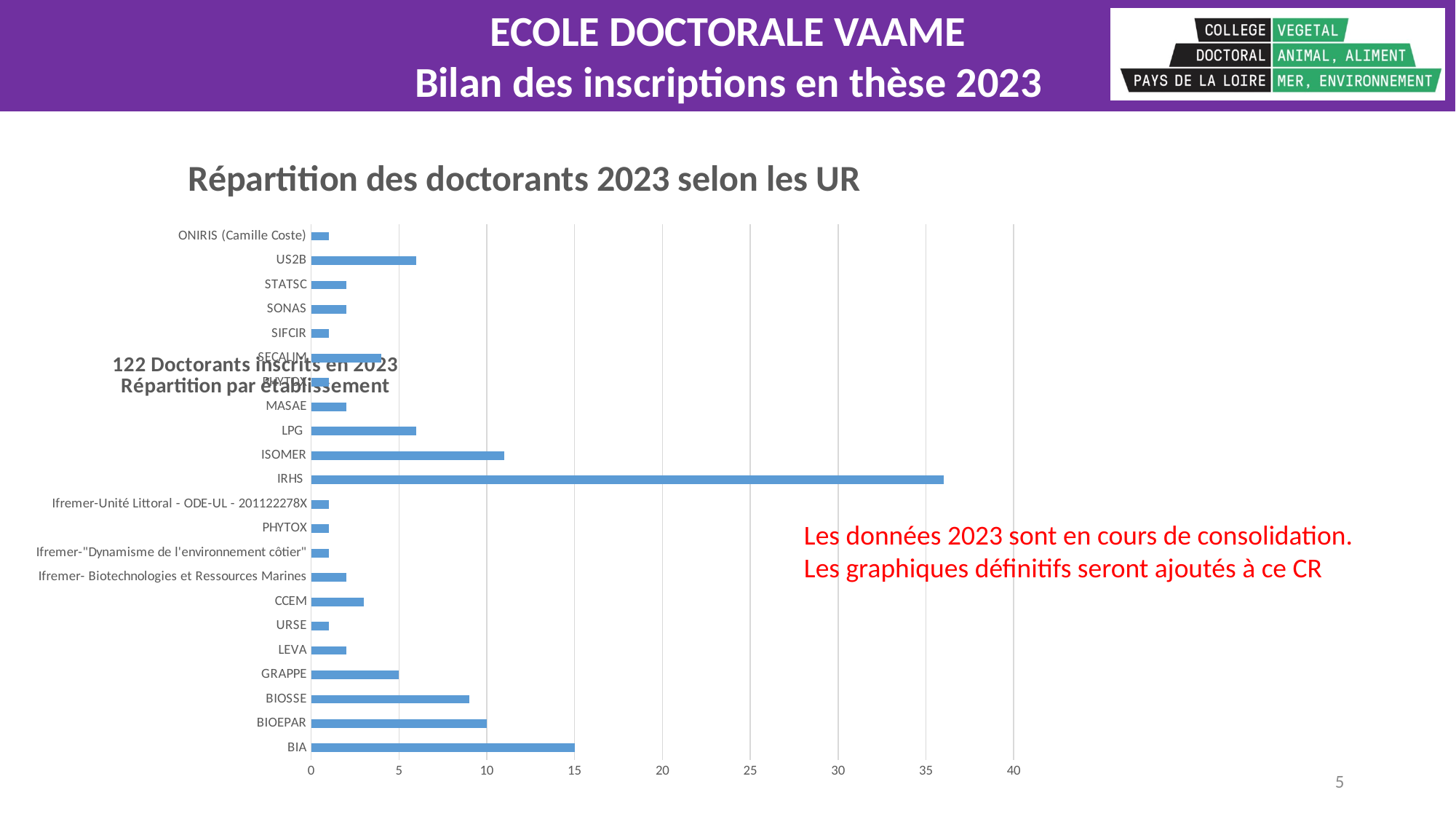
What is the value for GRAPPE? 5 Which has a larger value, BIA or BIOEPAR? BIA What kind of chart is shown on the slide? bar chart What is the title of the chart? Répartition des doctorants 2023 selon les UR Is the value for IRHS greater or less than 35? greater Which UR has the highest number of doctorants in the chart? IRHS What is the value for BIOEPAR? 10 Which has a larger value, ISOMER or BIOSSE? ISOMER Is the value for BIOSSE greater or less than 10? less What is the value for BIA? 15 Is the value for CCEM greater or less than 5? less What is the difference between the values for BIA and BIOEPAR? 5